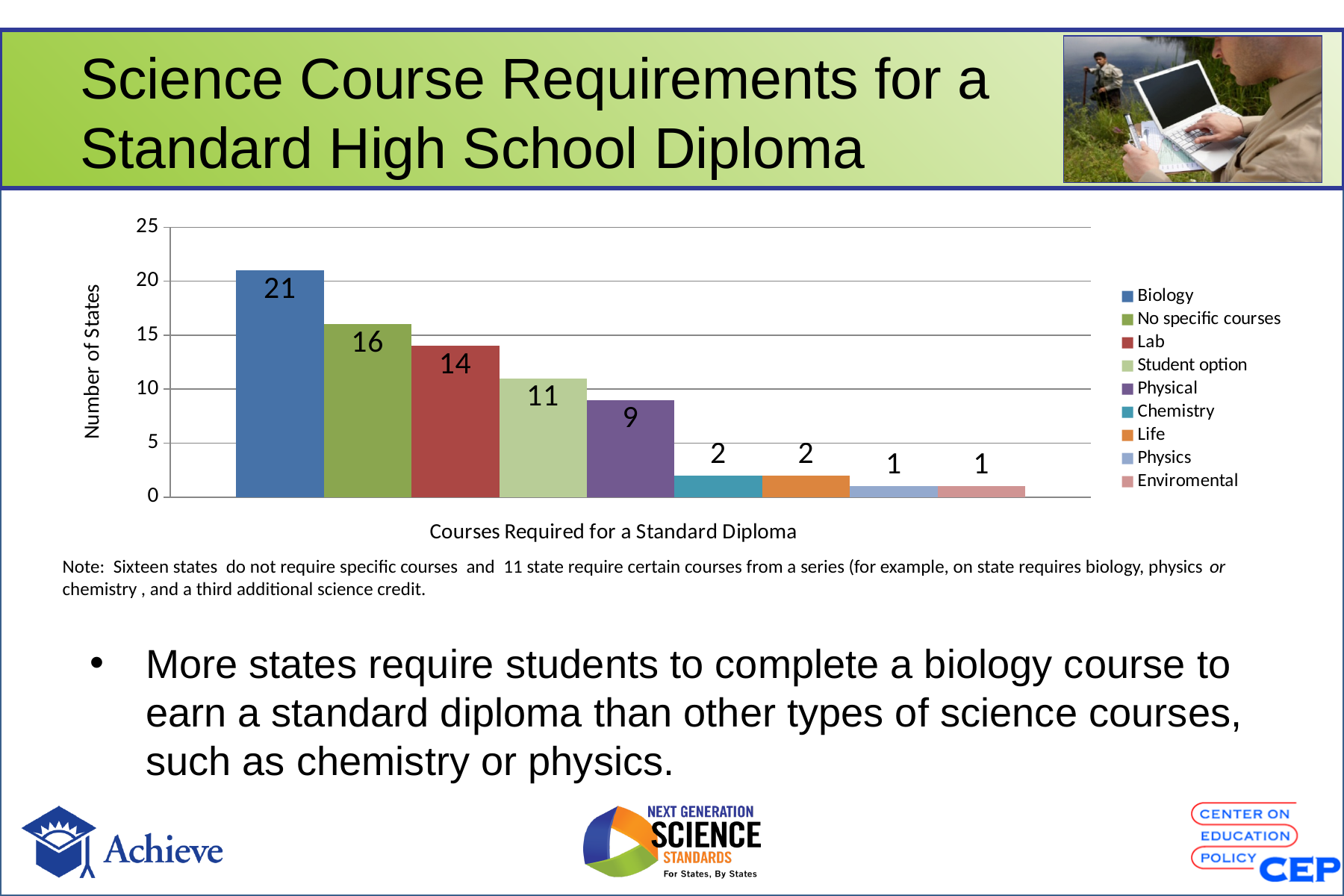
What is the label of the x axis? Courses Required for a Standard Diploma Which has more states, Physical or Chemistry? Physical What kind of chart is shown on the slide? bar chart What is the difference in number of states between Lab and Student option? 3 How many states require a biology course for a standard diploma? 21 What is the difference in number of states between Biology and No specific courses? 5 Is the value for Student option greater or less than 10? greater How many states require a lab course? 14 Which series has the highest number of states? Biology What is the label of the y axis? Number of States How many series does the legend list? 9 What is the number of states for the Physical series? 9